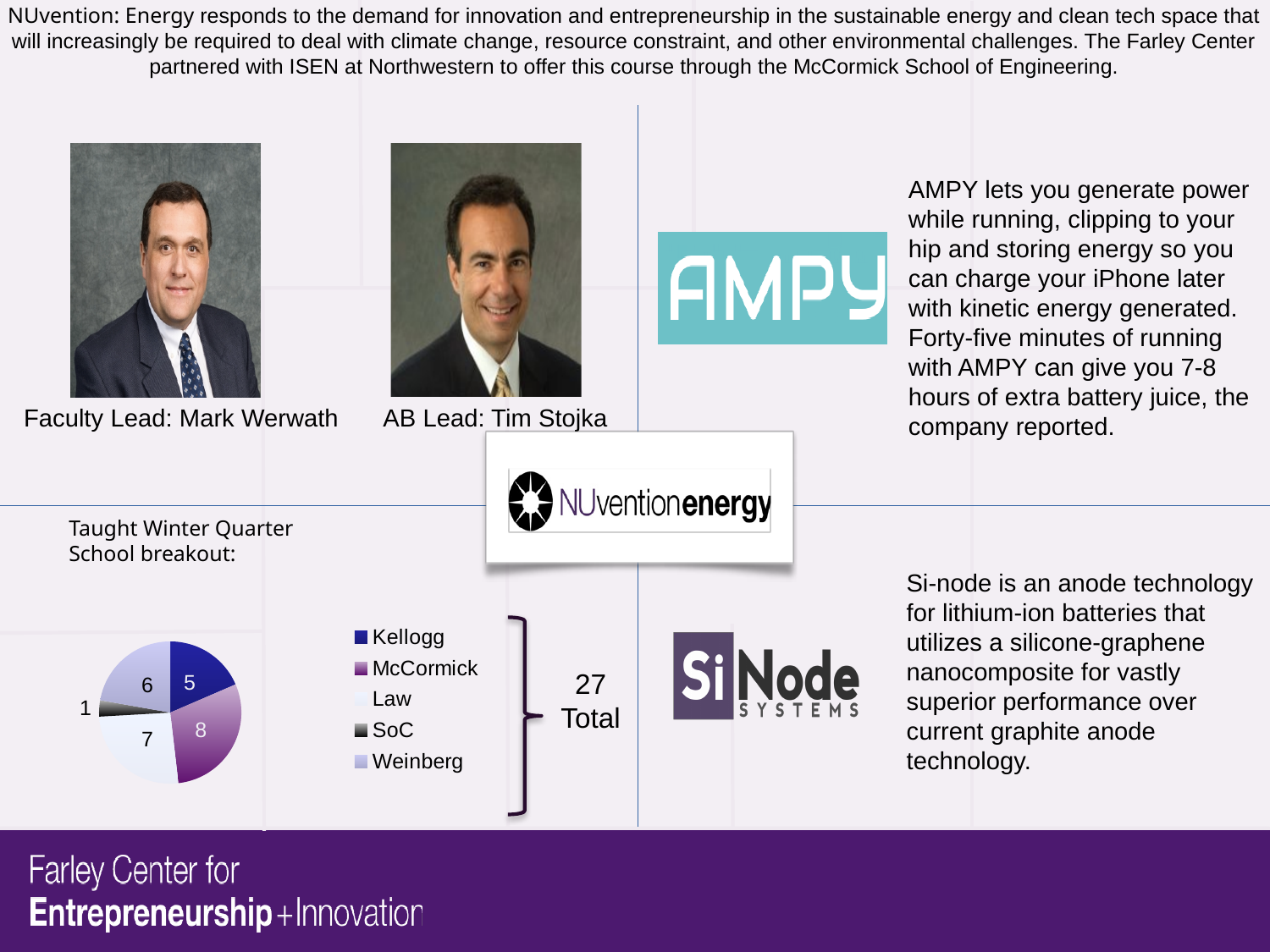
What value does the pie chart show for Weinberg? 6 What kind of chart is used to show the Winter Quarter school breakout? pie chart Which school has the largest slice in the school breakout pie chart? McCormick What value does the pie chart show for Law? 7 What is the difference between the McCormick and Kellogg values in the pie chart? 3 Which is larger in the pie chart, Law or Weinberg? Law What value does the pie chart show for Kellogg? 5 What is the total number of students across all slices of the pie chart? 27 How many students in the school breakout pie chart are from McCormick? 8 Which school has the smallest slice in the school breakout pie chart? SoC Which school is represented by the black slice in the pie chart? SoC How many schools are shown in the school breakout pie chart? 5